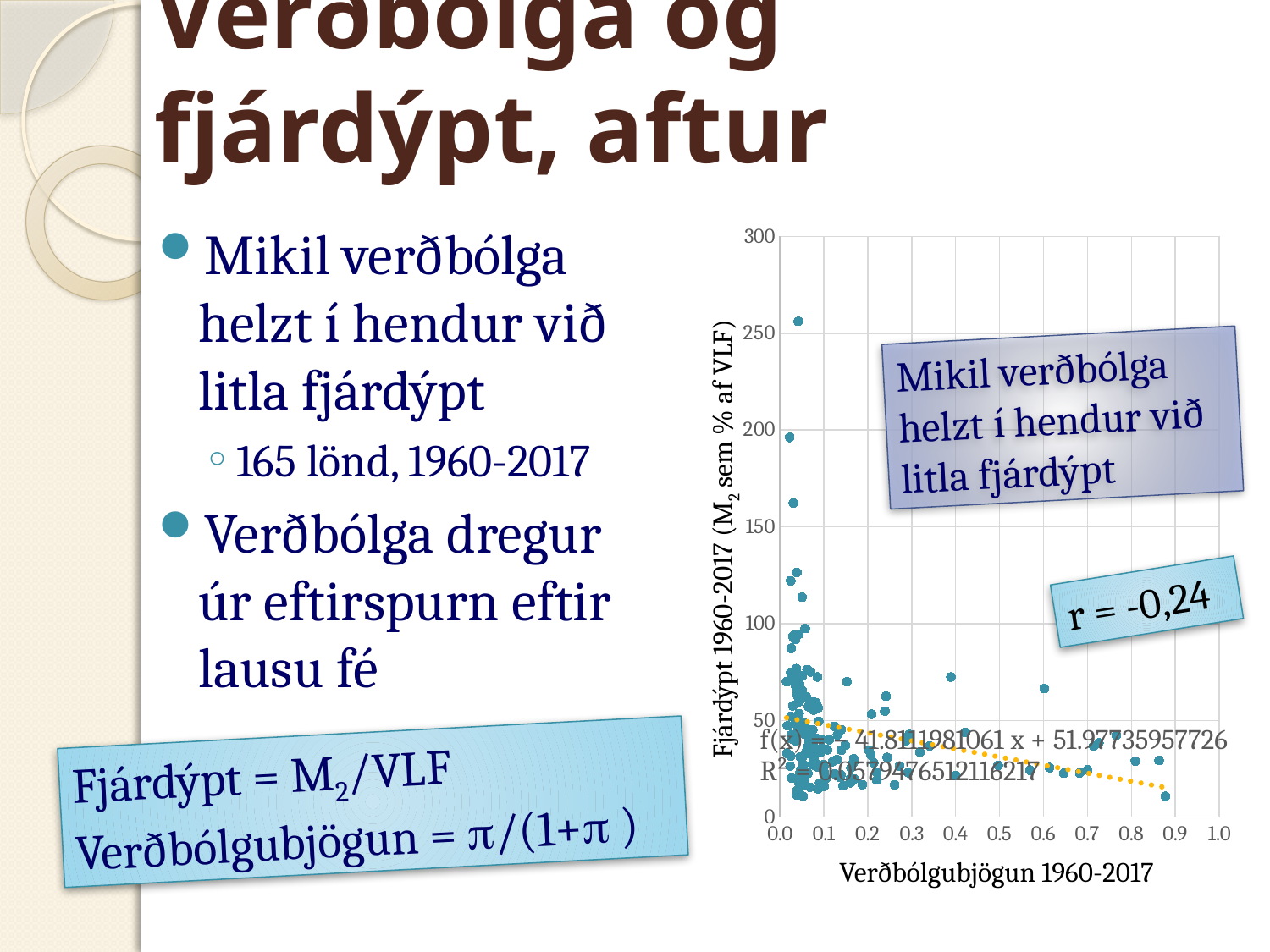
Is the highest Fjárdýpt value plotted in the scatter chart greater or less than 200? greater What is the maximum value shown on the y axis of the scatter chart? 300 What is the label of the y axis of the scatter chart? Fjárdýpt 1960-2017 (M2 sem % af VLF) What R² value is printed on the scatter chart? 0.0579476512116217 What correlation coefficient r is reported on the slide for the scatter chart? r = -0,24 What is the slope of the fitted line f(x) shown on the scatter chart? -41.8111981061 What is the label of the x axis of the scatter chart? Verðbólgubjögun 1960-2017 What kind of chart is shown on the slide? Scatter chart What is the intercept of the fitted line f(x) shown on the scatter chart? 51.97735957726 How many countries does the slide say are included in the scatter chart data? 165 Is the Fjárdýpt value of the point with the largest Verðbólgubjögun (near 0.9) greater or less than 50? less Does the fitted trend line in the scatter chart rise or fall as Verðbólgubjögun increases? Fall